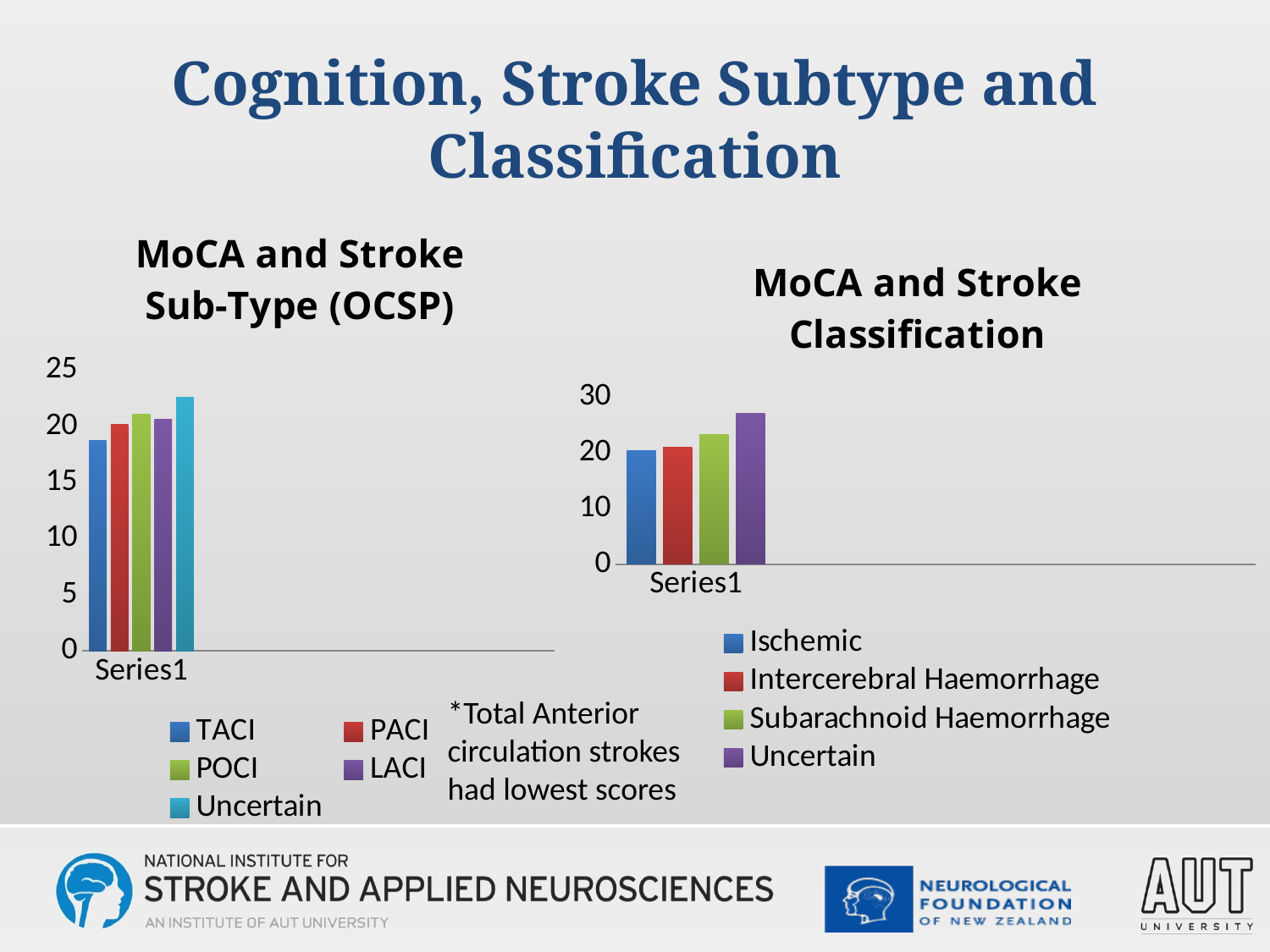
How many series does the legend of the 'MoCA and Stroke Classification' chart list? 4 In the 'MoCA and Stroke Classification' chart, which series has the highest bar? Uncertain In the 'MoCA and Stroke Classification' chart, is the value for Ischemic greater or less than 30? less In the 'MoCA and Stroke Classification' chart, which is larger, the value for Uncertain or the value for Ischemic? Uncertain In the 'MoCA and Stroke Sub-Type (OCSP)' chart, which series has the highest bar? Uncertain In the 'MoCA and Stroke Sub-Type (OCSP)' chart, which series has the lowest bar? TACI How many series does the legend of the 'MoCA and Stroke Sub-Type (OCSP)' chart list? 5 What is the title of the chart on the right side of the slide? MoCA and Stroke Classification What kind of chart is the 'MoCA and Stroke Sub-Type (OCSP)' chart? bar chart In the 'MoCA and Stroke Sub-Type (OCSP)' chart, is the value for Uncertain greater or less than 20? greater In the 'MoCA and Stroke Sub-Type (OCSP)' chart, is the value for TACI greater or less than 20? less